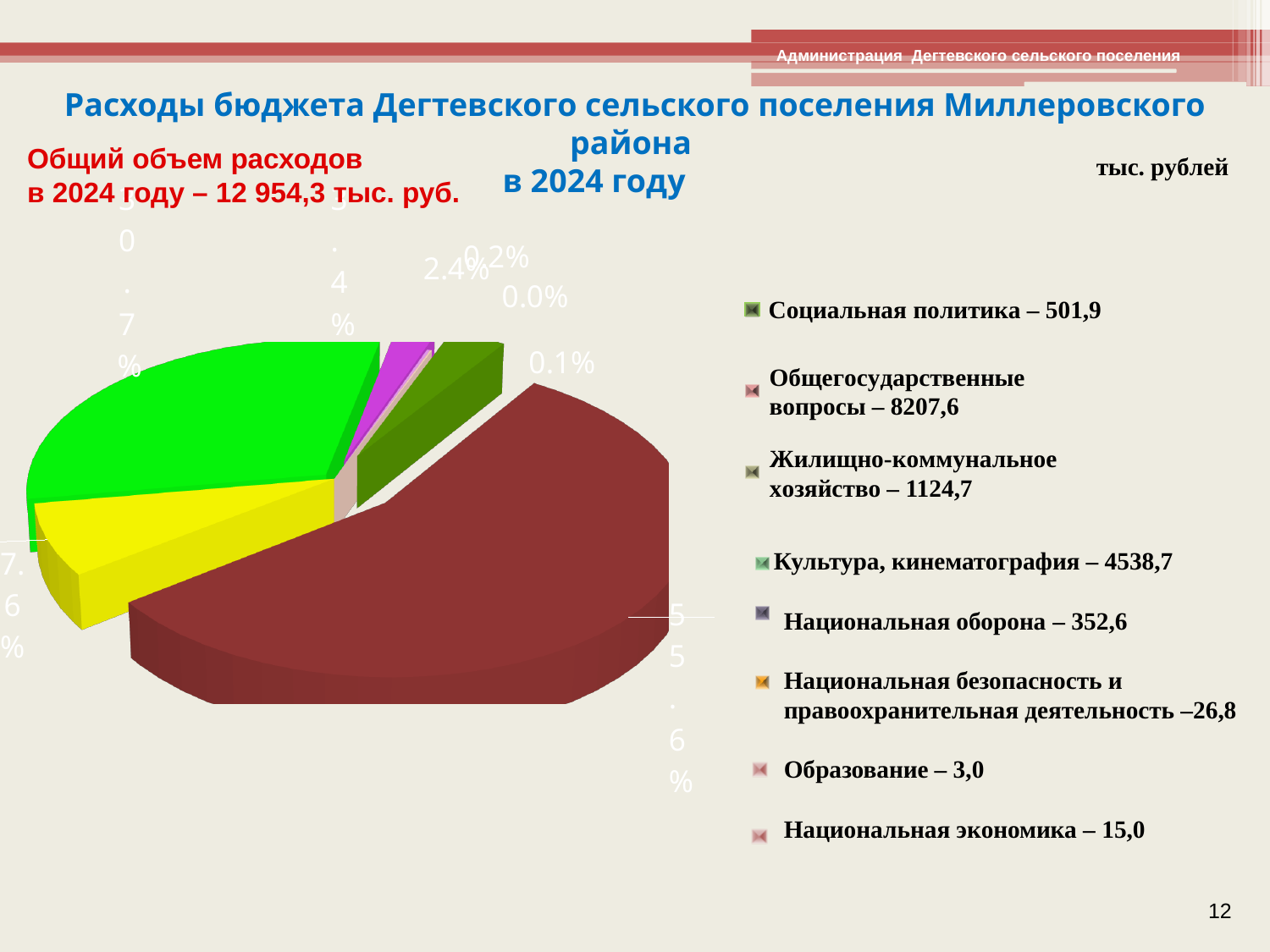
Which expenditure category has the lowest value? Образование Which expenditure category has the highest value? Общегосударственные вопросы How many expenditure categories are listed in the chart legend? 8 What is the difference between Национальная экономика and Образование? 12,0 What is the difference between Общегосударственные вопросы and Культура, кинематография? 3668,9 What is the total volume of expenditures in 2024 stated on the slide? 12 954,3 тыс. руб. Which is larger: Социальная политика or Жилищно-коммунальное хозяйство? Жилищно-коммунальное хозяйство What is the value for Жилищно-коммунальное хозяйство? 1124,7 What is the value for Общегосударственные вопросы? 8207,6 What kind of chart is shown on the slide? pie chart What is the value for Национальная оборона? 352,6 What is the value for Культура, кинематография? 4538,7